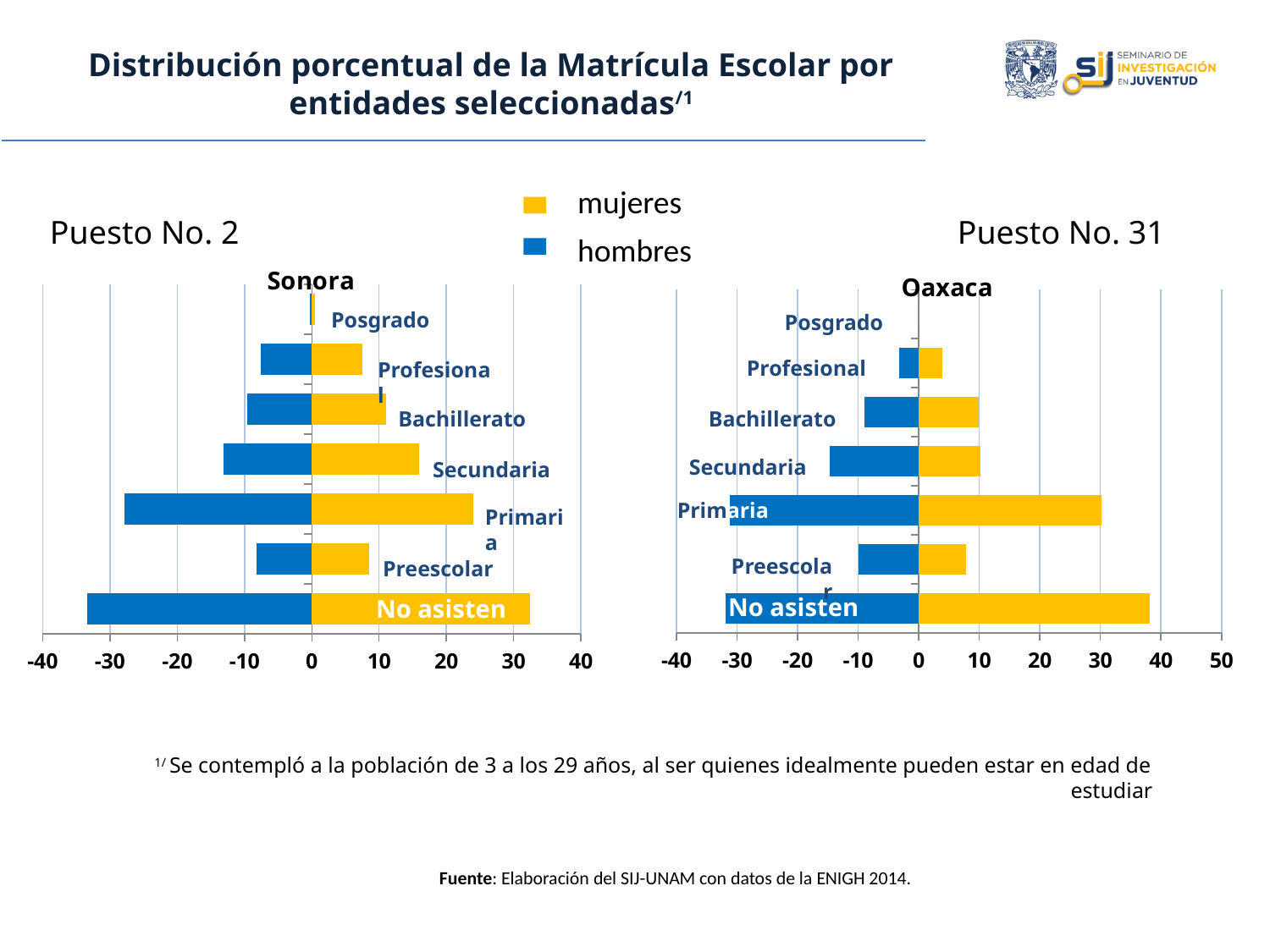
In the Sonora chart, which category has the lowest value for mujeres? Posgrado In the Oaxaca chart, which is larger for mujeres: No asisten or Primaria? No asisten In the Sonora chart, which is larger for mujeres: Primaria or Secundaria? Primaria In the Sonora chart, is the mujeres value for No asisten greater or less than 30? greater In the Sonora chart, which category has the highest value for mujeres? No asisten What kind of chart is the Sonora chart? bar chart In the Oaxaca chart, is the mujeres value for Profesional greater or less than 10? less How many education categories are shown in the Oaxaca chart? 7 How many series does the legend list? 2 Which colour represents hombres in the legend? blue In the Oaxaca chart, which category has the highest value for mujeres? No asisten In the Sonora chart, is the mujeres value for Secundaria greater or less than 10? greater